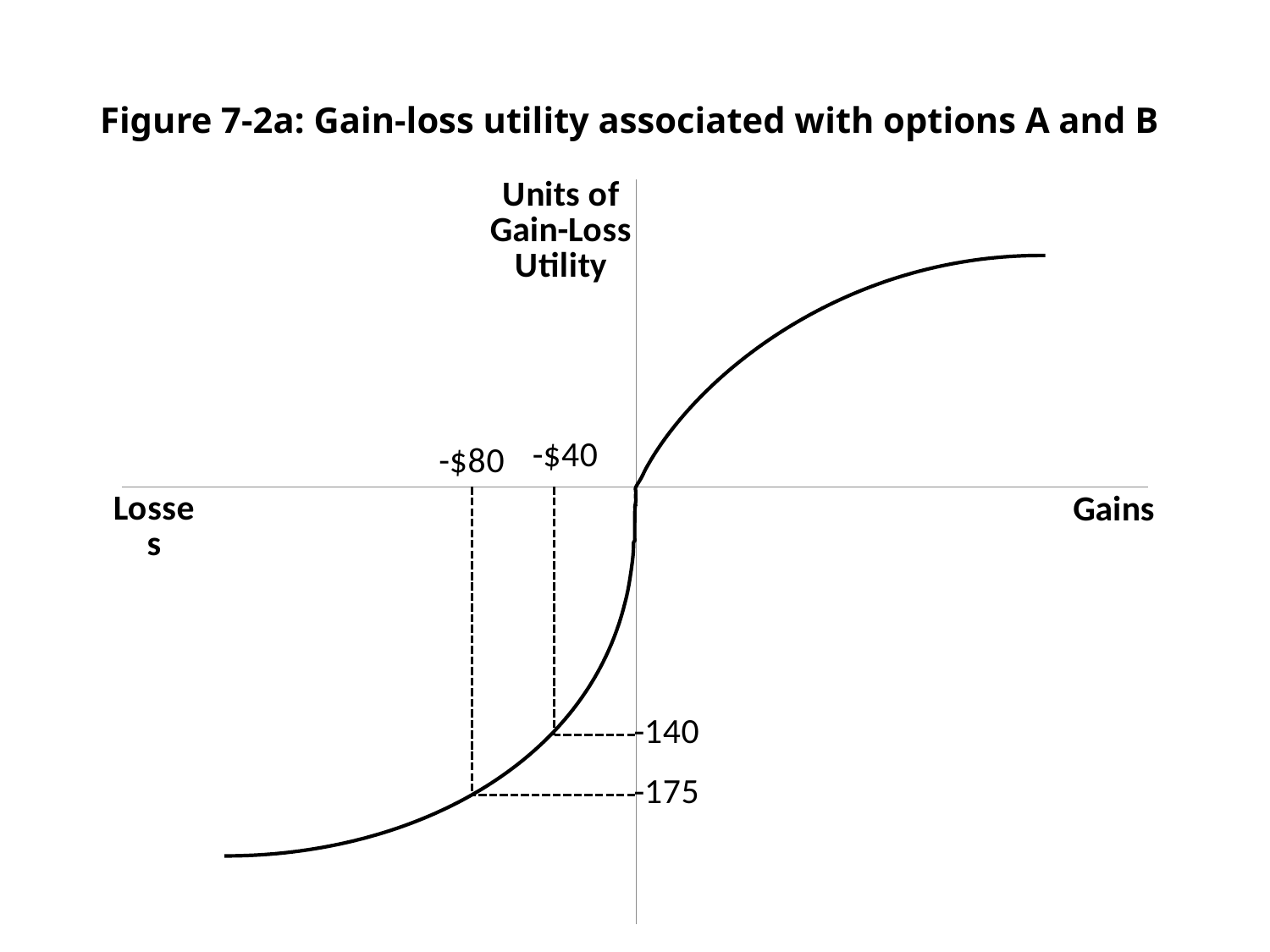
What is the difference between the utility values marked for -$40 and -$80? 35 How many loss amounts are marked with dashed lines on the chart? 2 Which loss amount, -$40 or -$80, corresponds to the lower gain-loss utility? -$80 What is the gain-loss utility value marked for a loss of -$80? -175 What is the title of the figure? Figure 7-2a: Gain-loss utility associated with options A and B Which of the two marked loss amounts has the higher (less negative) gain-loss utility? -$40 What is the gain-loss utility value marked for a loss of -$40? -140 What is the label on the vertical axis? Units of Gain-Loss Utility Does the curve rise or fall as you move from losses to gains along the horizontal axis? rise What kind of chart is shown on the slide? line chart